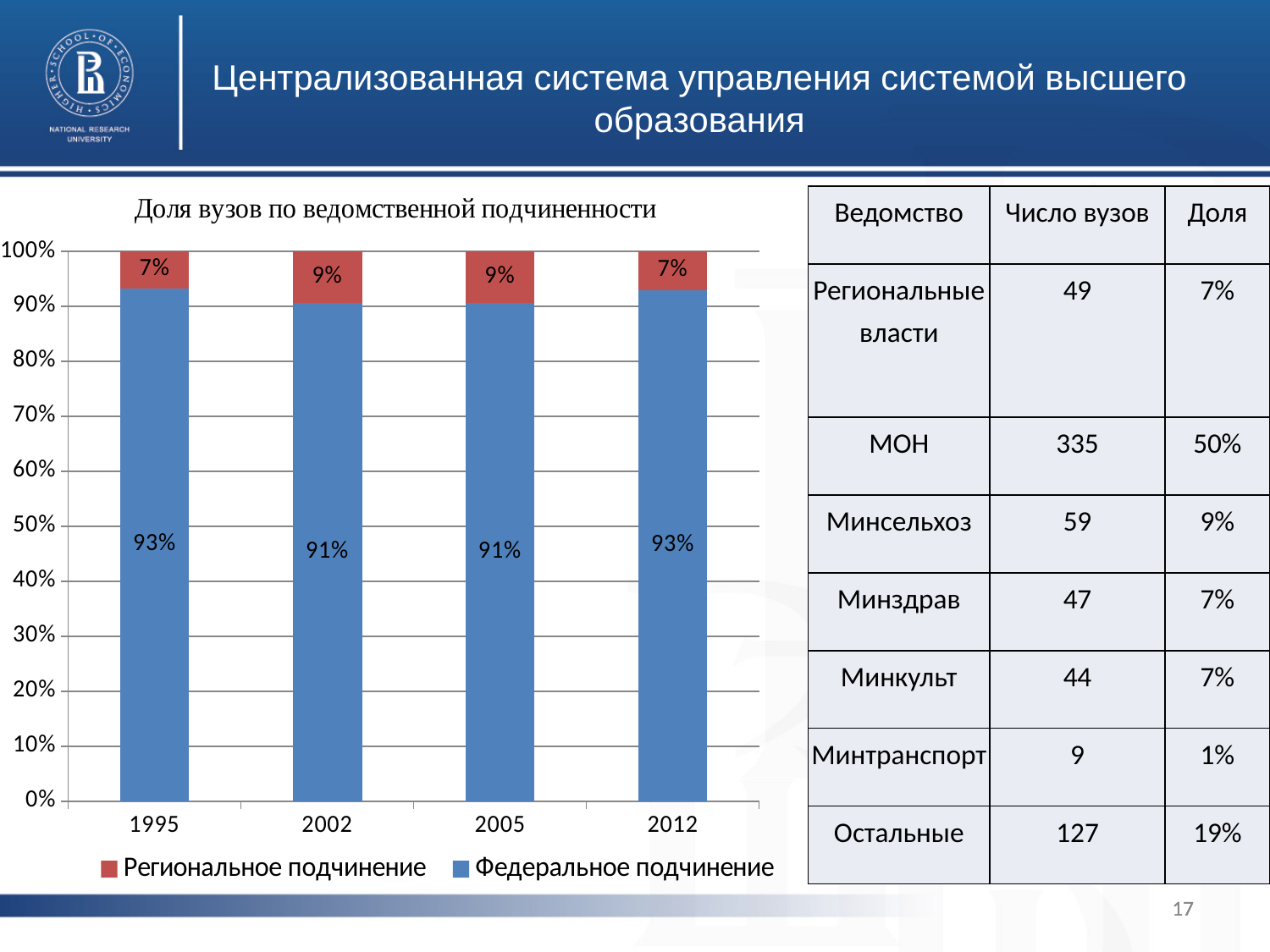
In which years is the share of Региональное подчинение highest? 2002 and 2005 Which is larger: the Региональное подчинение value in 2005 or in 2012? 2005 What is the value for Региональное подчинение in 2012? 7% What kind of chart is shown on the slide? Stacked bar chart What is the title of the chart? Доля вузов по ведомственной подчиненности How many series does the chart legend list? 2 What is the value for Федеральное подчинение in 2005? 91% What is the difference between the Федеральное подчинение values for 1995 and 2002? 2% How many years are shown on the x axis of the chart? 4 What is the value for Региональное подчинение in 2002? 9% What is the value for Федеральное подчинение in 1995? 93% Is the value for Федеральное подчинение in 2002 greater or less than 50%? greater